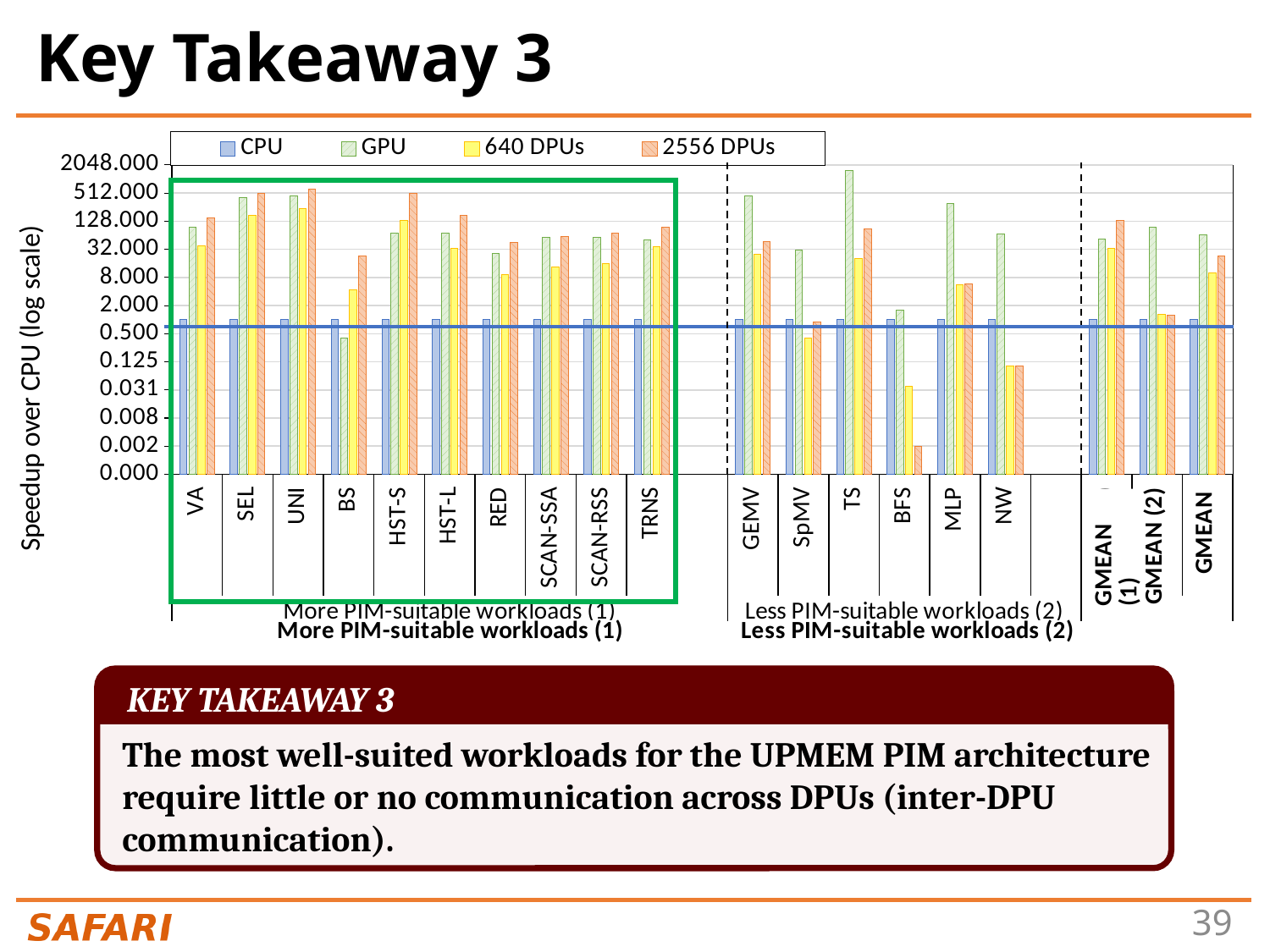
Which workload has the highest GPU bar? TS How many workload categories (including the GMEAN entries) are plotted along the x axis? 19 Which series does the legend list last? 2556 DPUs What kind of chart is shown on the slide? bar chart For BS, which series has the highest bar? 2556 DPUs Is the GPU value for TS greater or less than 512.000? greater For MLP, which is larger: the GPU value or the 2556 DPUs value? GPU What is the label of the y axis of the chart? Speedup over CPU (log scale) Is the 2556 DPUs value for SEL greater or less than 128.000? greater Is the GPU value for BS greater or less than 0.500? less How many series does the chart legend list? 4